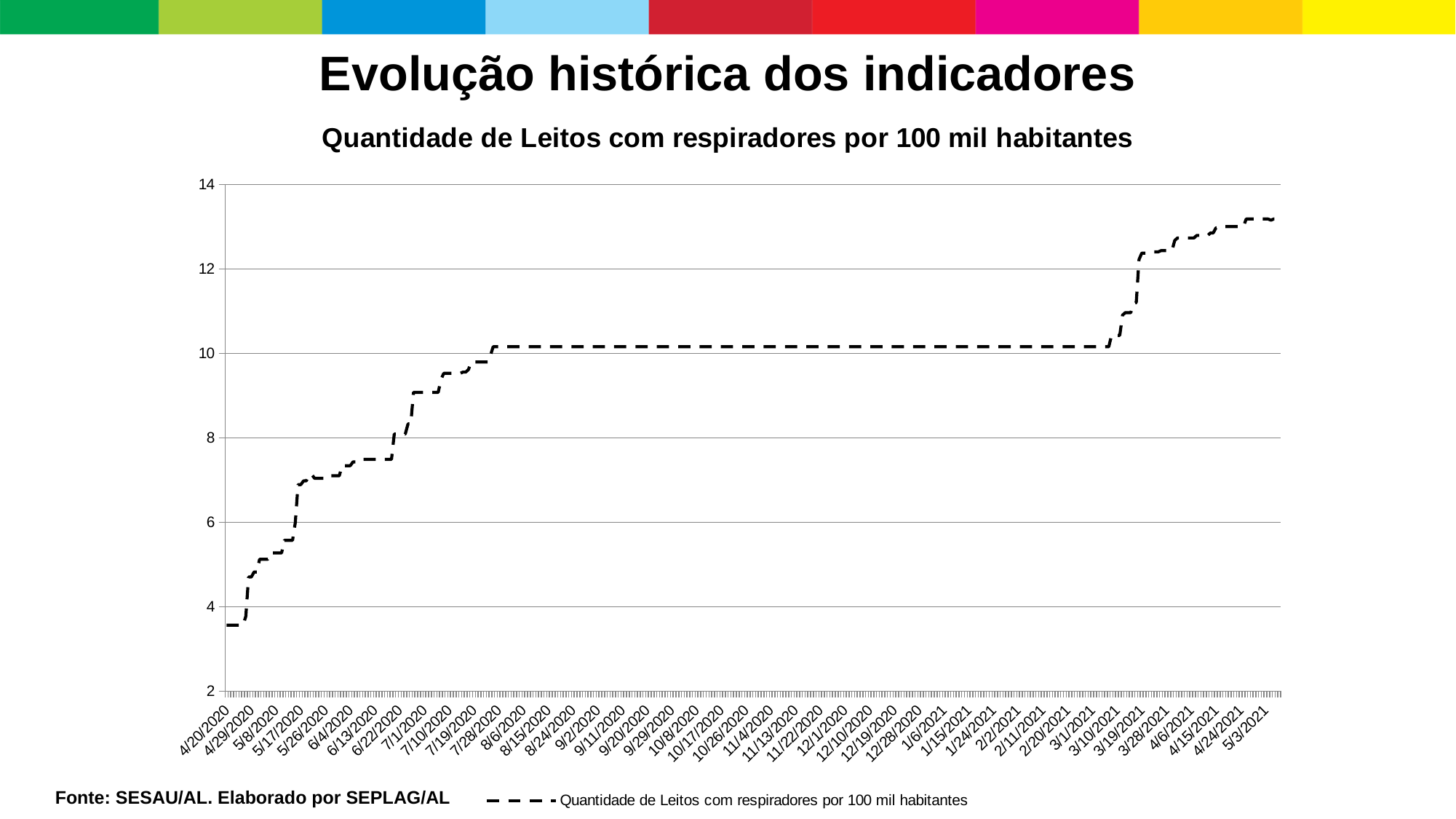
Is the value for 10/8/2020 greater or less than 8? greater Is the value for 4/20/2020 greater or less than 4? less What is the title of the chart? Quantidade de Leitos com respiradores por 100 mil habitantes Is the value for 5/8/2020 greater or less than 6? less Overall, do the values rise or fall from 4/20/2020 to 5/3/2021? rise What kind of chart is shown on the slide? line chart How many series does the legend list? 1 Which is larger, the value for 7/28/2020 or the value for 5/26/2020? 7/28/2020